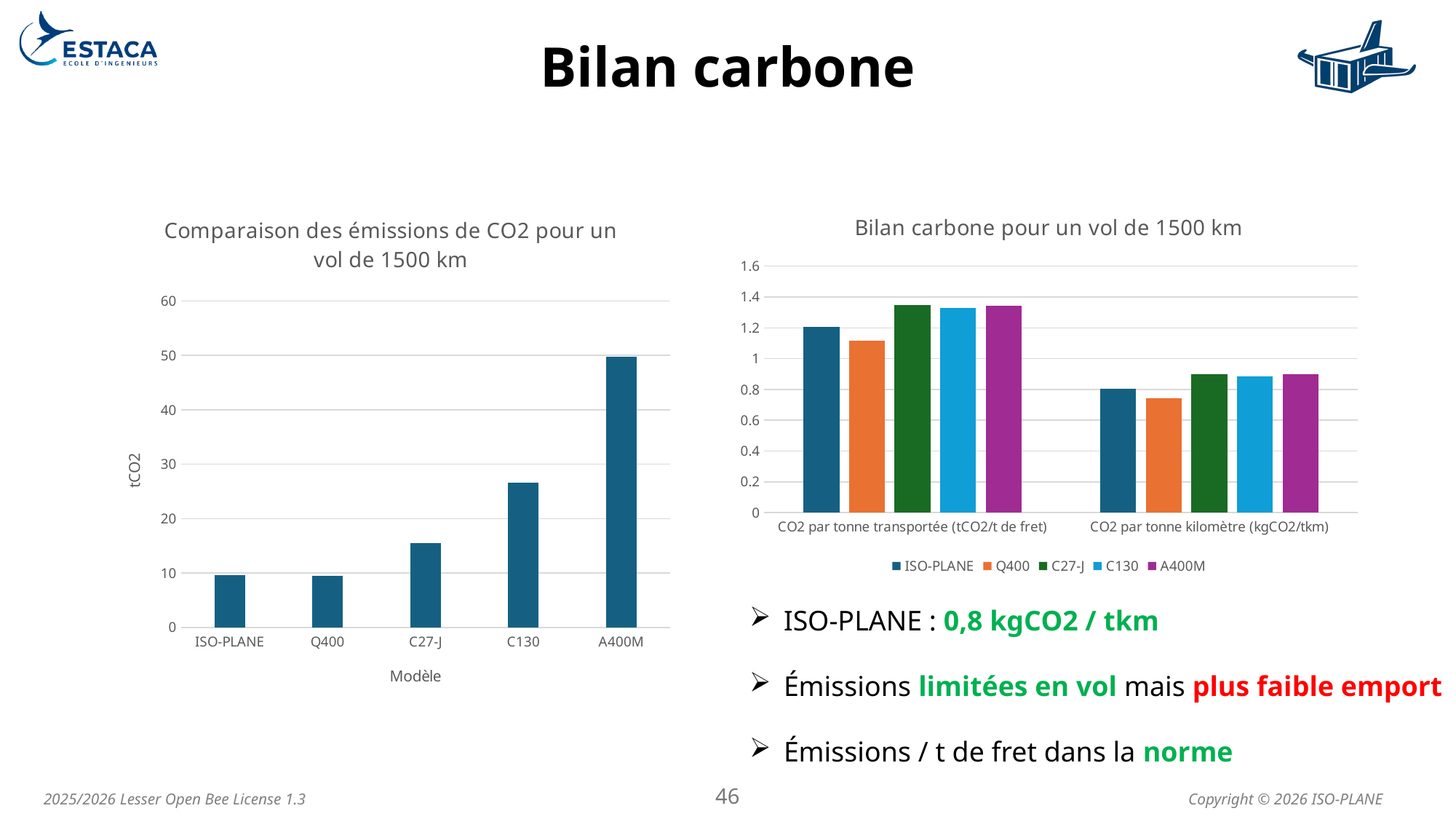
In the right chart 'Bilan carbone pour un vol de 1500 km', which model has the lowest value for 'CO2 par tonne kilomètre (kgCO2/tkm)'? Q400 What type of chart is the left chart titled 'Comparaison des émissions de CO2 pour un vol de 1500 km'? Bar chart In the left chart 'Comparaison des émissions de CO2 pour un vol de 1500 km', is the value for C130 greater or less than 20? greater In the left chart 'Comparaison des émissions de CO2 pour un vol de 1500 km', what is the label of the y axis? tCO2 In the right chart 'Bilan carbone pour un vol de 1500 km', which is larger for 'CO2 par tonne transportée (tCO2/t de fret)', ISO-PLANE or Q400? ISO-PLANE In the left chart 'Comparaison des émissions de CO2 pour un vol de 1500 km', which is larger, the value for C130 or the value for C27-J? C130 In the right chart 'Bilan carbone pour un vol de 1500 km', is the value for C27-J in 'CO2 par tonne transportée (tCO2/t de fret)' greater or less than 1.2? greater In the left chart 'Comparaison des émissions de CO2 pour un vol de 1500 km', how many aircraft models are shown on the x axis? 5 In the right chart 'Bilan carbone pour un vol de 1500 km', how many series does the legend list? 5 In the left chart 'Comparaison des émissions de CO2 pour un vol de 1500 km', is the value for ISO-PLANE greater or less than 20? less In the left chart 'Comparaison des émissions de CO2 pour un vol de 1500 km', which model has the highest CO2 emissions? A400M